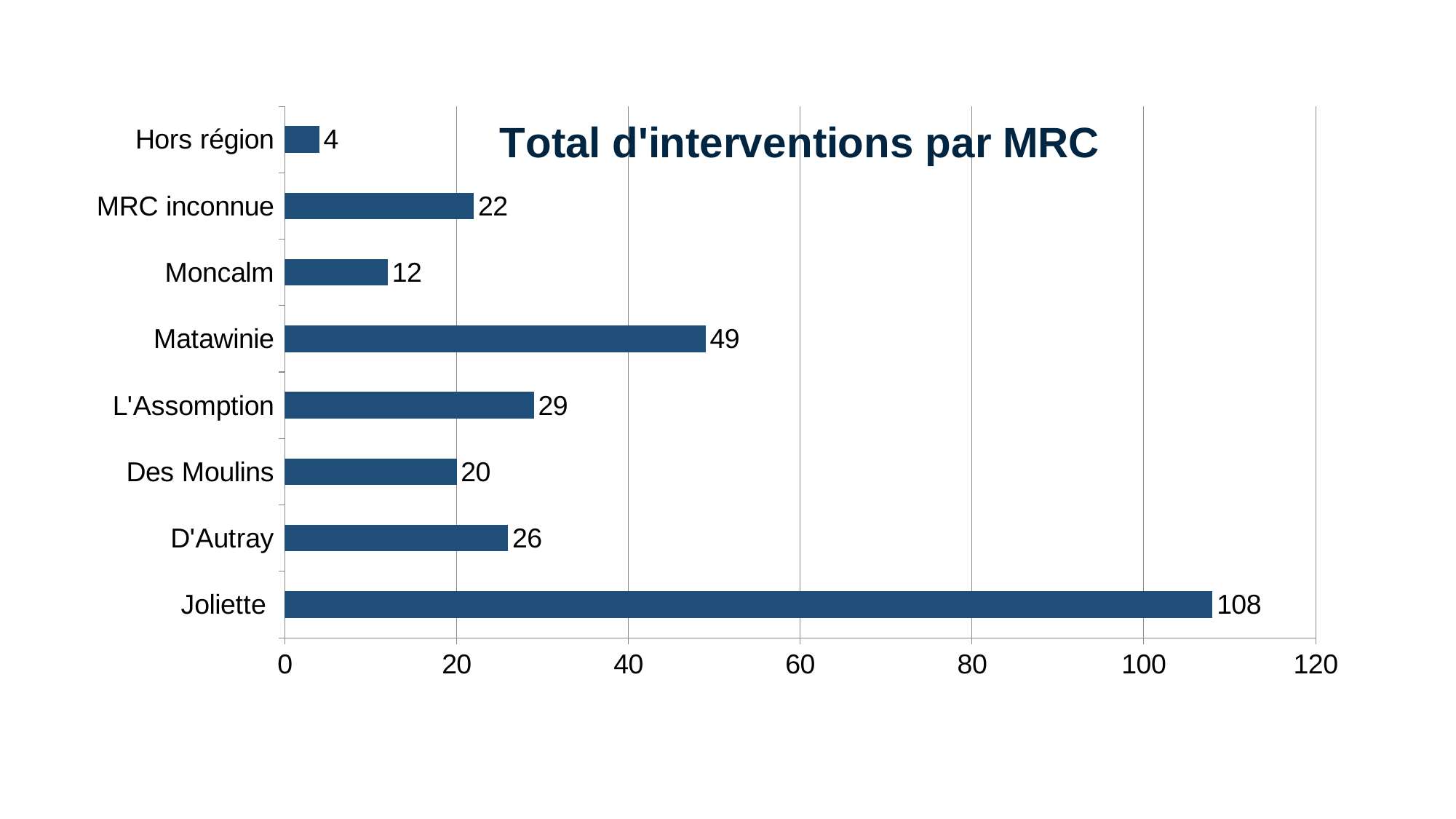
What is the title of the chart? Total d'interventions par MRC What is the difference between the values for Joliette and Matawinie? 59 What is the value for Matawinie? 49 Which category has the lowest value? Hors région Is the value for Matawinie greater or less than 40? greater What is the value for MRC inconnue? 22 What is the value for Joliette? 108 Which is larger, the value for Des Moulins or the value for Moncalm? Des Moulins What kind of chart is shown on the slide? bar chart What is the difference between the values for L'Assomption and D'Autray? 3 Which category has the highest value? Joliette How many categories are shown in the chart? 8